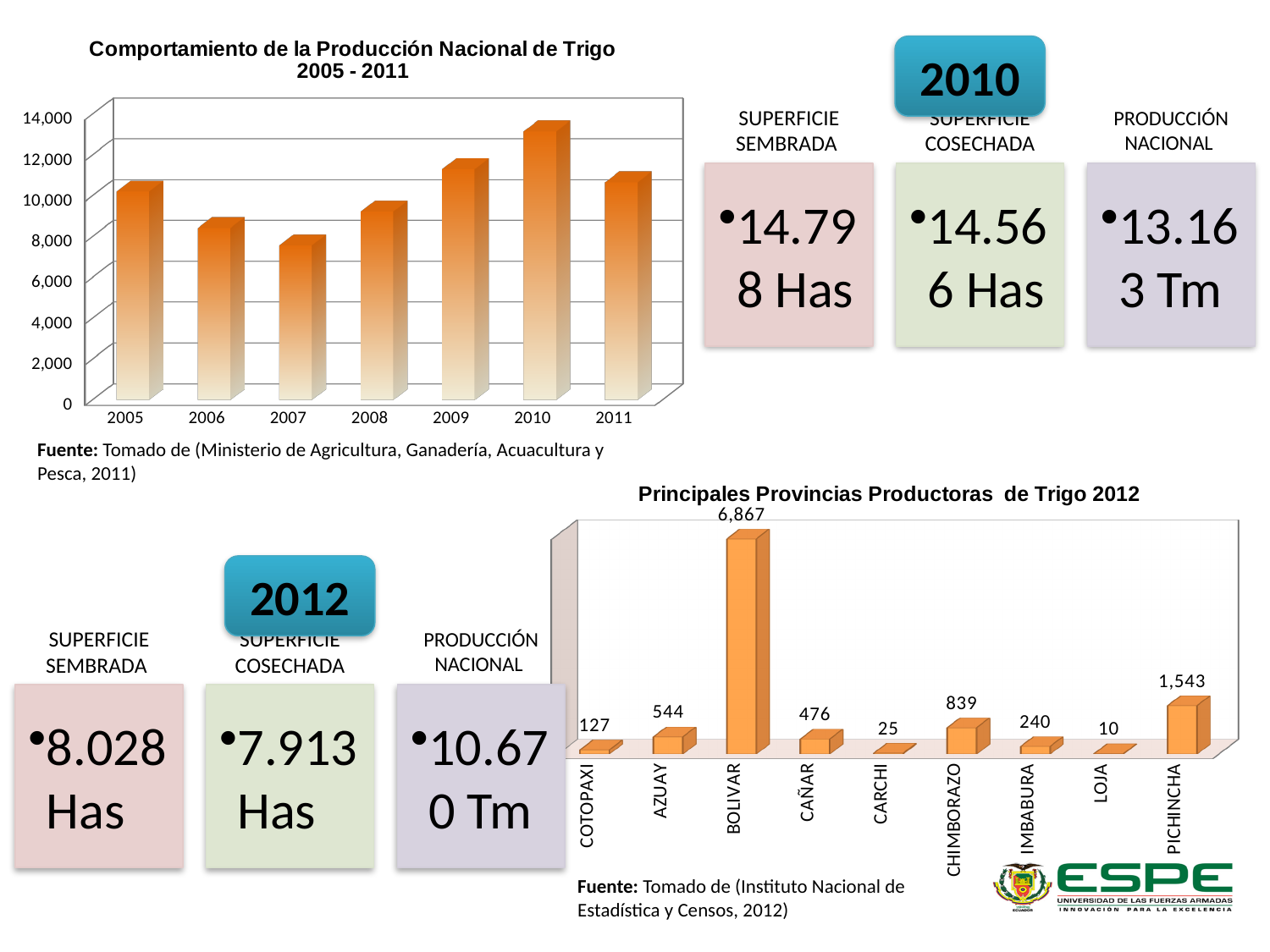
In the chart 'Principales Provincias Productoras de Trigo 2012', what is the value for CHIMBORAZO? 839 In the chart 'Principales Provincias Productoras de Trigo 2012', what is the value for BOLIVAR? 6,867 In the chart 'Principales Provincias Productoras de Trigo 2012', which province has the highest value? BOLIVAR What kind of chart is 'Comportamiento de la Producción Nacional de Trigo 2005 - 2011'? bar chart In the chart 'Comportamiento de la Producción Nacional de Trigo 2005 - 2011', which year has the highest value? 2010 In the chart 'Comportamiento de la Producción Nacional de Trigo 2005 - 2011', is the value for 2009 greater or less than 10,000? greater In the chart 'Principales Provincias Productoras de Trigo 2012', what is the difference between the values for AZUAY and CAÑAR? 68 In the chart 'Principales Provincias Productoras de Trigo 2012', what is the value for PICHINCHA? 1,543 How many provinces are shown in the chart 'Principales Provincias Productoras de Trigo 2012'? 9 In the chart 'Principales Provincias Productoras de Trigo 2012', which is larger, the value for IMBABURA or the value for COTOPAXI? IMBABURA In the chart 'Principales Provincias Productoras de Trigo 2012', which province has the lowest value? LOJA In the chart 'Comportamiento de la Producción Nacional de Trigo 2005 - 2011', which year has the lowest value? 2007